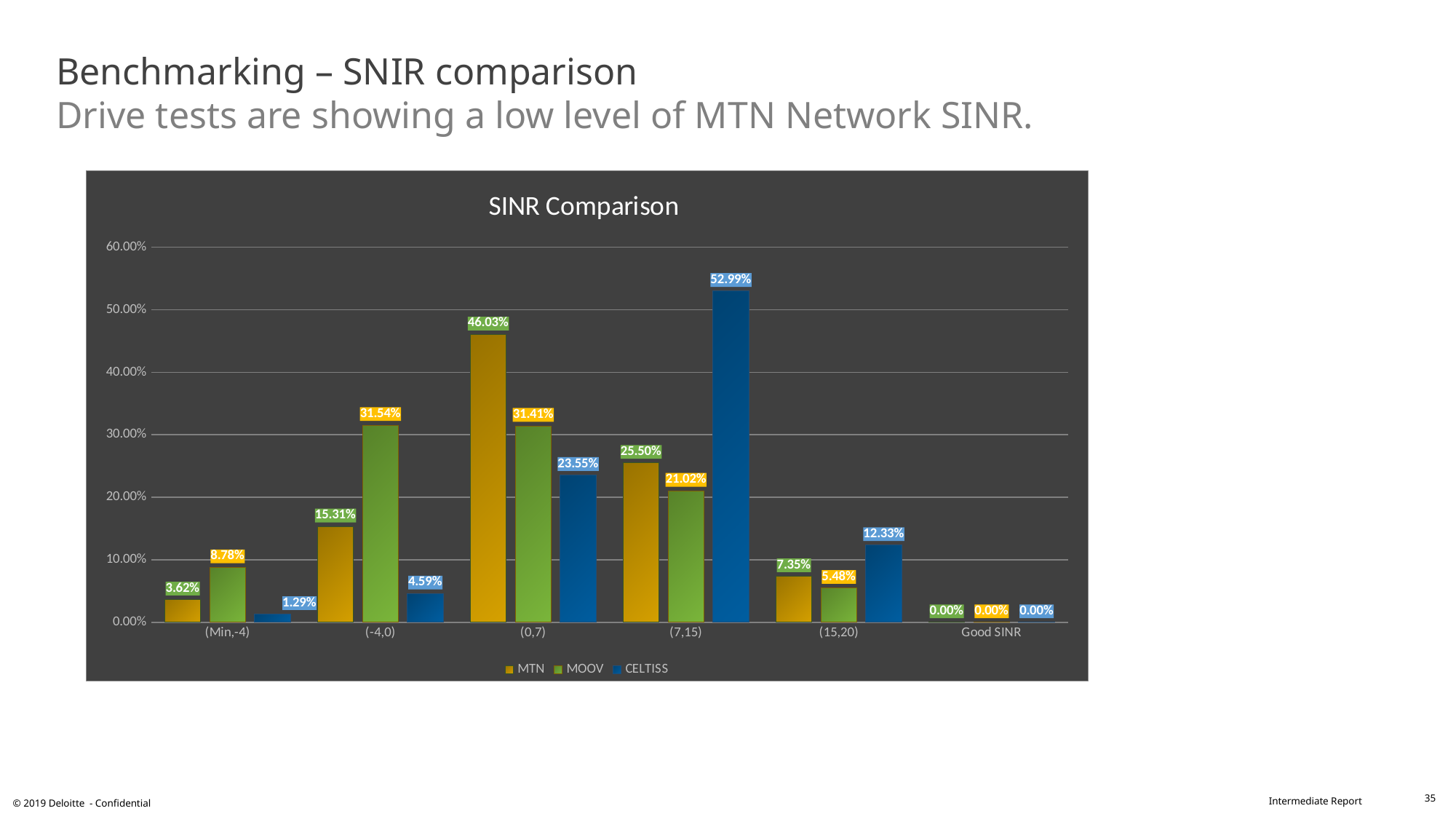
What is the difference between the MTN and MOOV values in the (0,7) category? 14.62% In which category does MTN have its highest value? (0,7) In which category does CELTISS have its highest value? (7,15) What is the MOOV value for the (15,20) category? 5.48% How many series does the legend list? 3 What kind of chart is shown on the slide? Bar chart What is the MTN value for the (0,7) category? 46.03% What is the title of the chart? SINR Comparison What is the CELTISS value for the (7,15) category? 52.99% In the (-4,0) category, which is larger: MTN or MOOV? MOOV What is the difference between the CELTISS and MTN values in the (7,15) category? 27.49% How many categories are shown on the x axis? 6